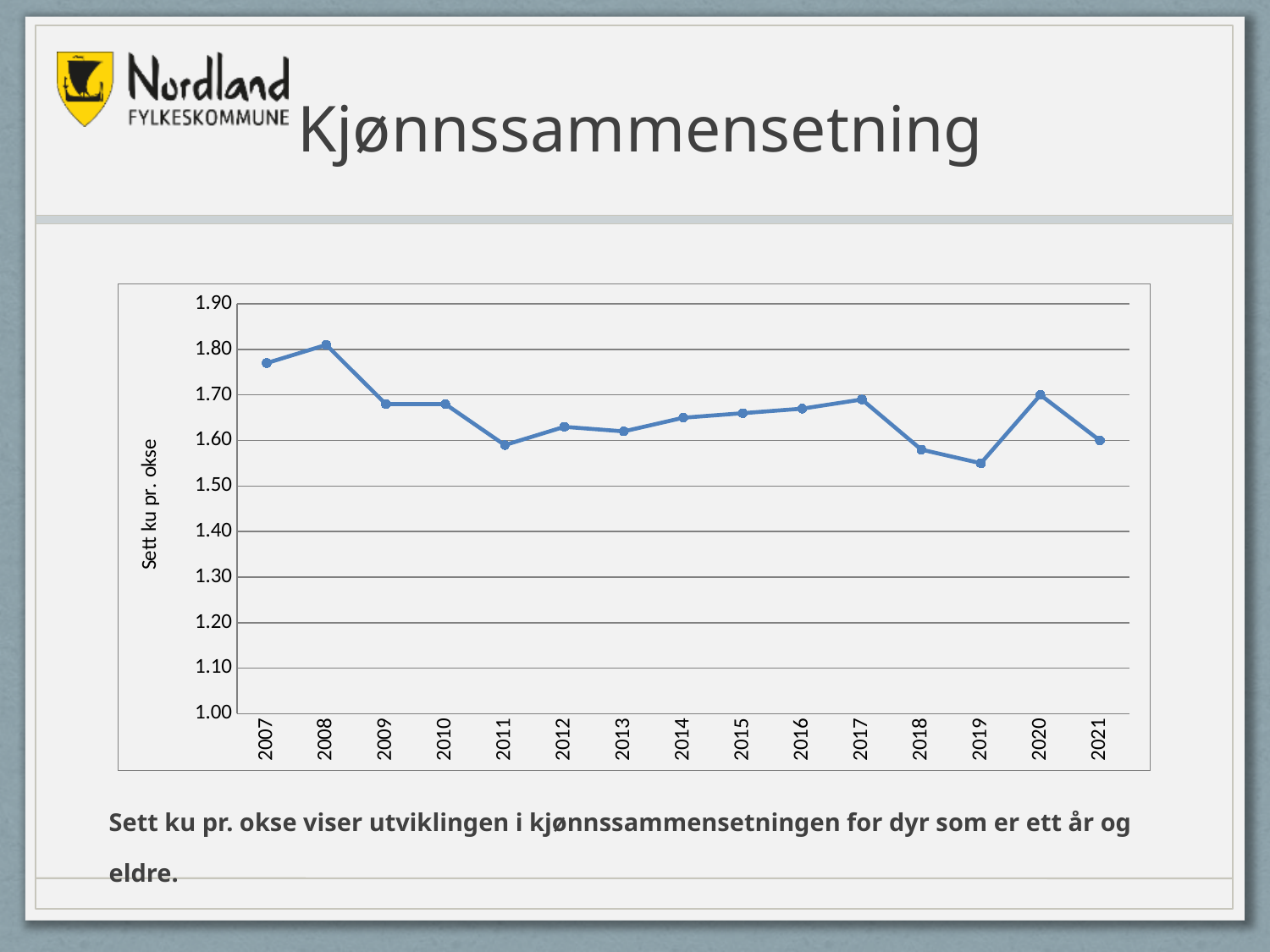
Which year has the highest value of Sett ku pr. okse? 2008 Which is larger, the value for 2008 or the value for 2019? 2008 What is the value of Sett ku pr. okse for 2020? 1.70 What kind of chart is shown on the slide? line chart Is the value for 2007 greater or less than 1.70? greater Which year has the lowest value of Sett ku pr. okse? 2019 Is the value for 2019 greater or less than 1.60? less What is the label on the vertical axis of the chart? Sett ku pr. okse Is the value for 2013 greater or less than 1.50? greater What is the value of Sett ku pr. okse for 2021? 1.60 How many years are plotted on the x axis? 15 Does the value of Sett ku pr. okse overall rise or fall from 2007 to 2021? fall